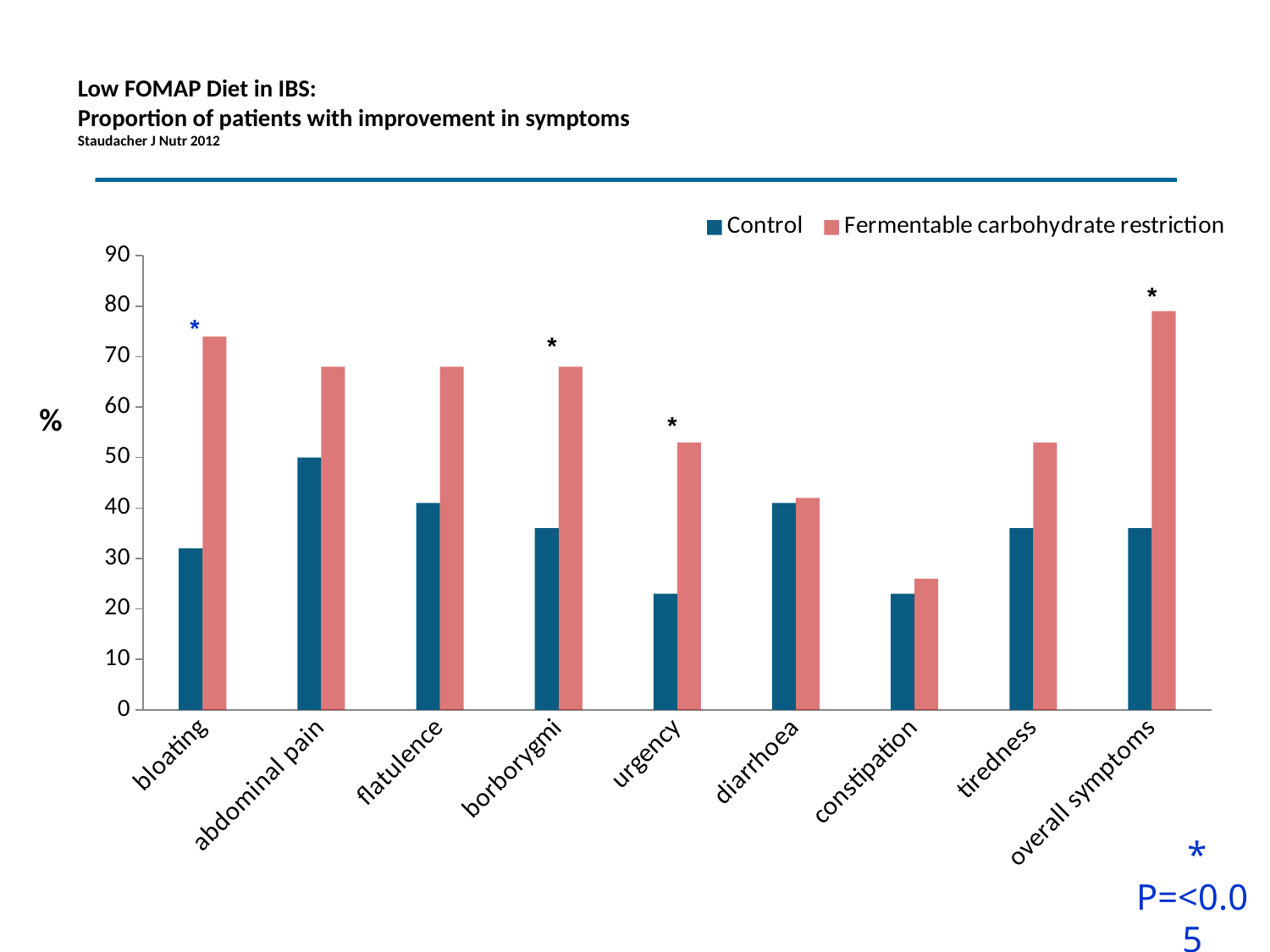
Which symptom has the highest value for the Fermentable carbohydrate restriction series? overall symptoms Which symptom has the highest value for the Control series? abdominal pain Is the Control value for urgency greater or less than 30? less Is the Fermentable carbohydrate restriction value for tiredness greater or less than 50? greater Which symptom has the lowest value for the Fermentable carbohydrate restriction series? constipation Is the Control value for borborygmi greater or less than 40? less How many series does the legend list? 2 How many symptom categories are shown on the x axis? 9 For bloating, which series has the larger value, Control or Fermentable carbohydrate restriction? Fermentable carbohydrate restriction What kind of chart is shown on the slide? bar chart What is the label on the y axis of the chart? %